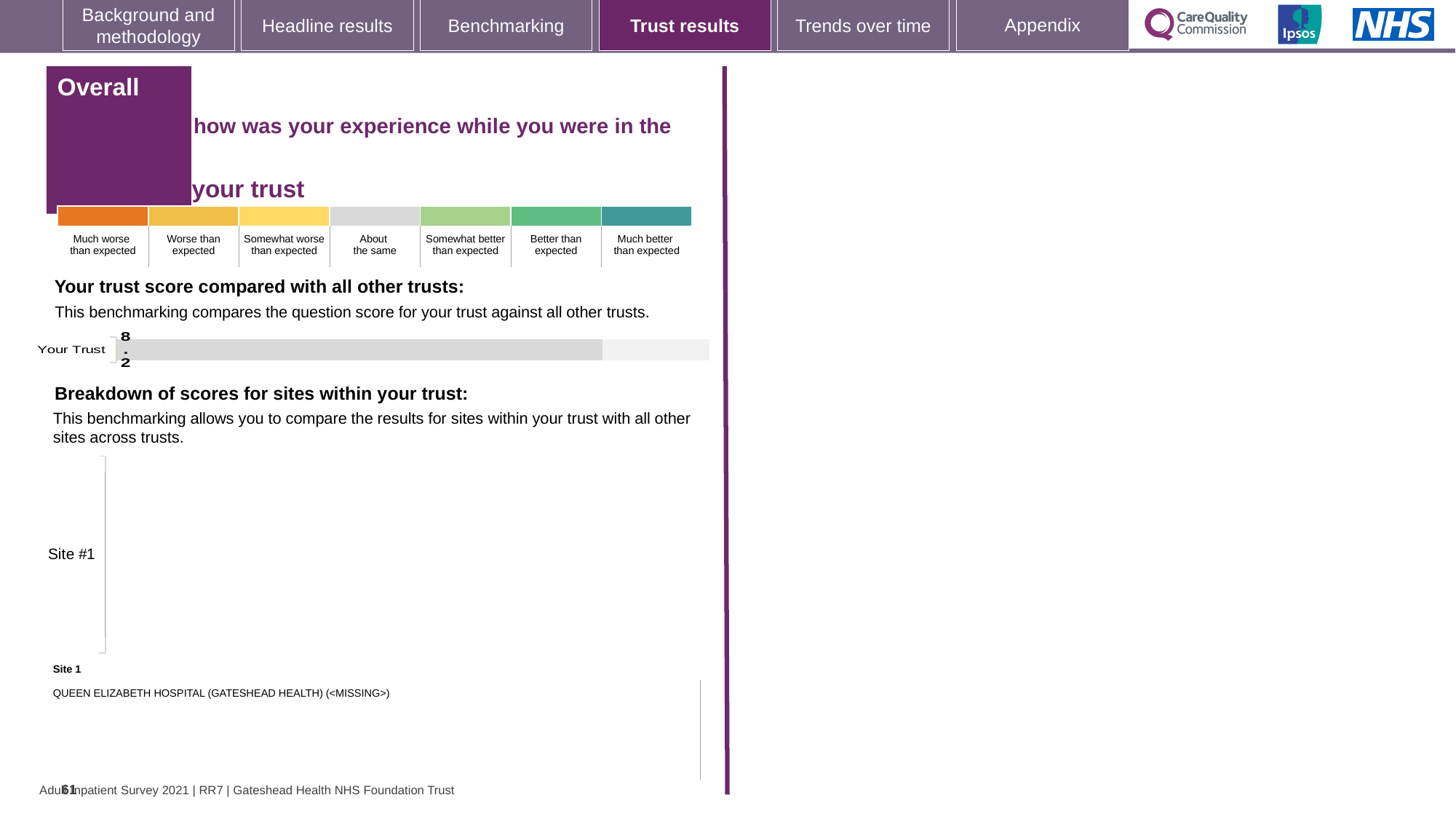
How many bars are plotted in the 'Your trust score compared with all other trusts' chart? 1 How many sites are listed in the 'Breakdown of scores for sites within your trust' chart? 1 What kind of chart is used to show the trust score compared with all other trusts? bar chart How many colour bands are shown in the expectation legend above the charts? 7 What is the score shown for Your Trust in the trust score comparison chart? 8.2 What is the label of the single category in the trust score comparison chart? Your Trust